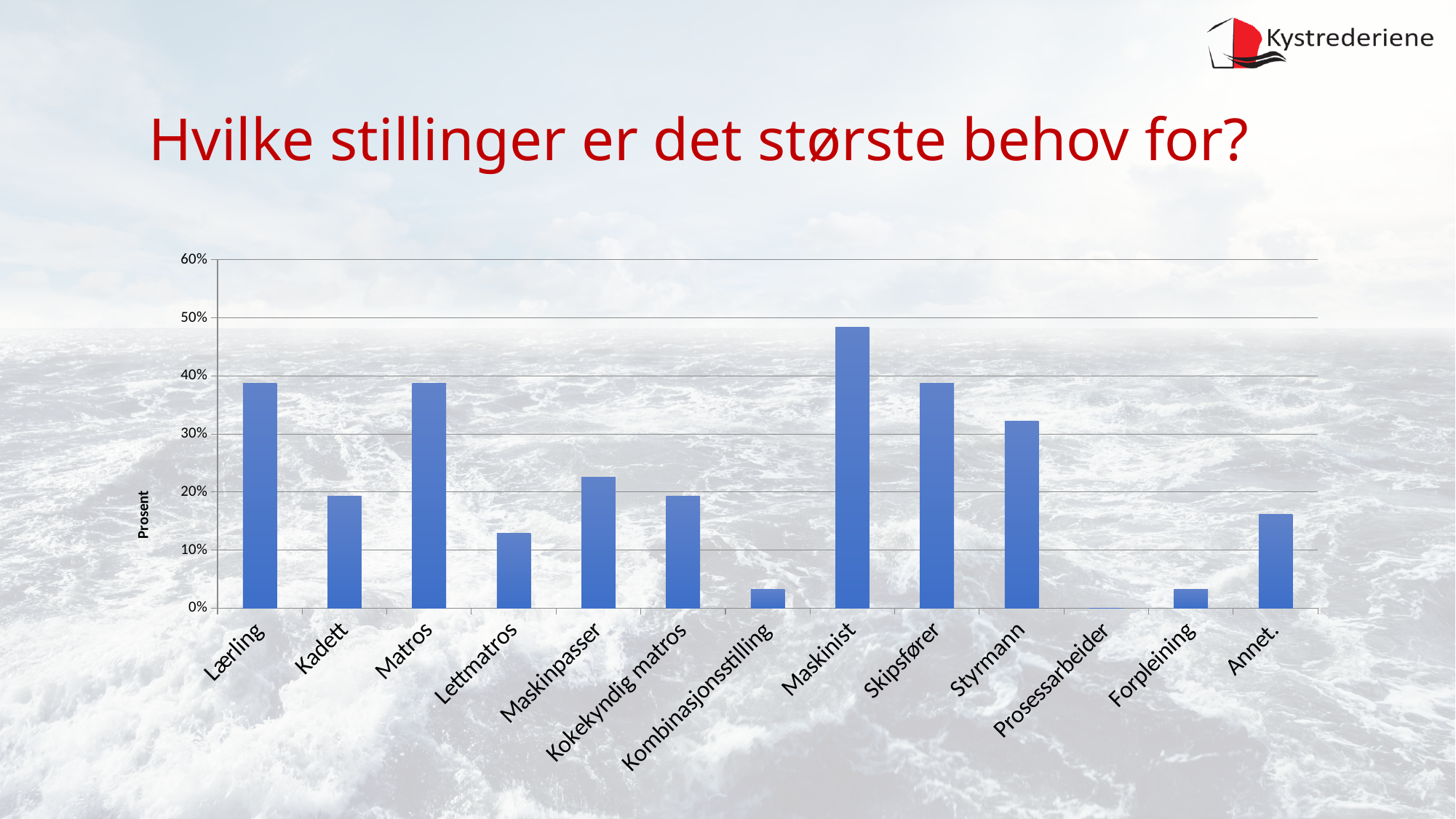
Which is larger, the value for Maskinist or the value for Styrmann? Maskinist What is the title of the slide above the chart? Hvilke stillinger er det største behov for? Is the value for Styrmann greater or less than 30%? greater Which position has the highest value in the chart? Maskinist Which position has the lowest value in the chart? Prosessarbeider Is the value for Lettmatros greater or less than 20%? less Which is larger, the value for Maskinpasser or the value for Lettmatros? Maskinpasser Is the value for Kombinasjonsstilling greater or less than 10%? less How many positions (categories) are shown on the x axis? 13 What is the label on the vertical axis of the chart? Prosent What kind of chart is shown on the slide? bar chart